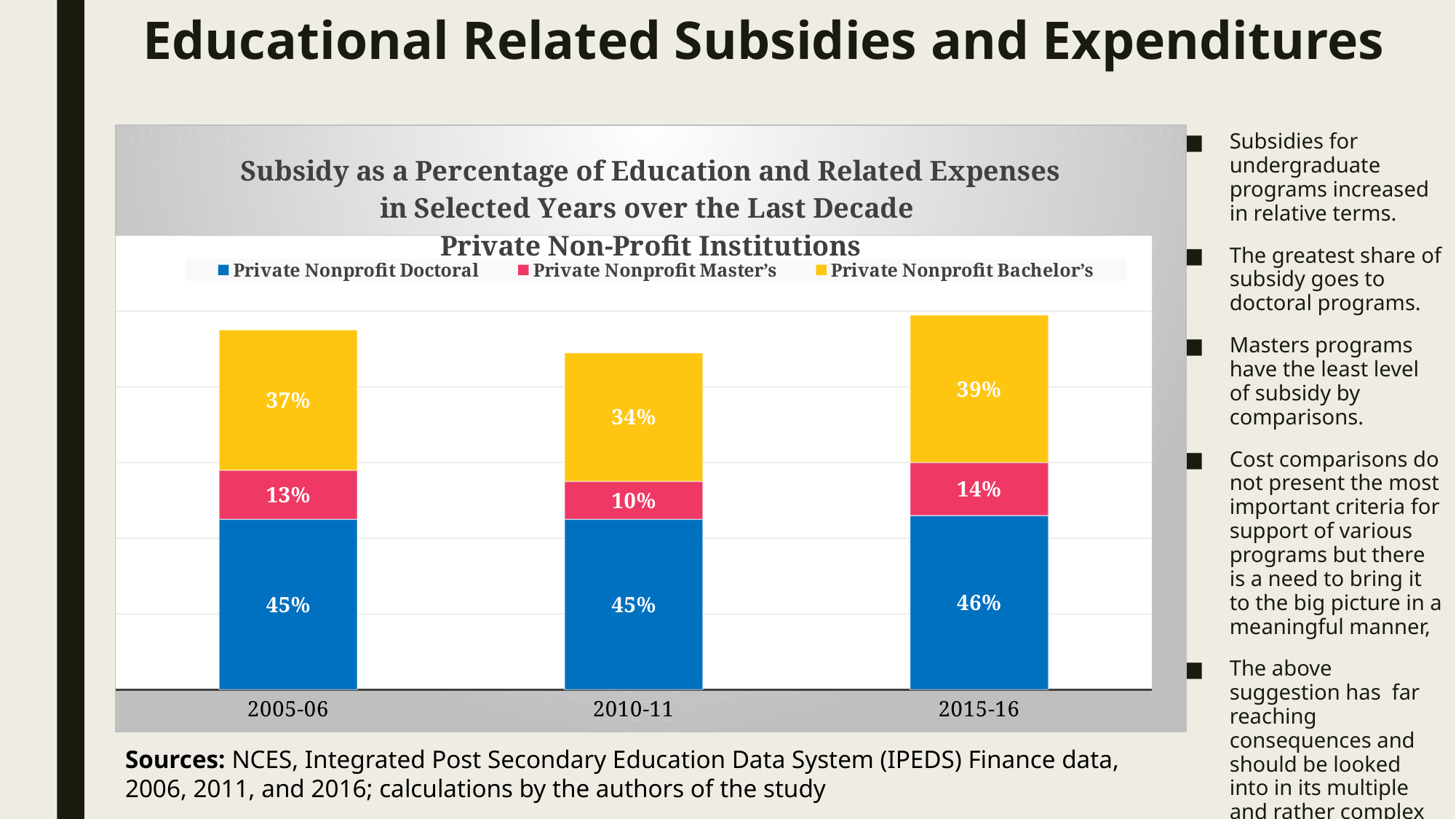
Which colour represents Private Nonprofit Master's in the chart? Pink/red What kind of chart is shown? Stacked bar chart What is the value for Private Nonprofit Master's in 2010-11? 10% What is the value for Private Nonprofit Doctoral in 2005-06? 45% How many series does the legend list? 3 Which is larger in 2005-06: Private Nonprofit Doctoral or Private Nonprofit Bachelor's? Private Nonprofit Doctoral In which year is the Private Nonprofit Bachelor's value lowest? 2010-11 What is the difference between the Private Nonprofit Bachelor's values in 2015-16 and 2010-11? 5% What is the total of the stacked bar for 2015-16? 99% How many years are shown on the x axis? 3 In which year is the Private Nonprofit Master's value highest? 2015-16 What is the value for Private Nonprofit Bachelor's in 2015-16? 39%